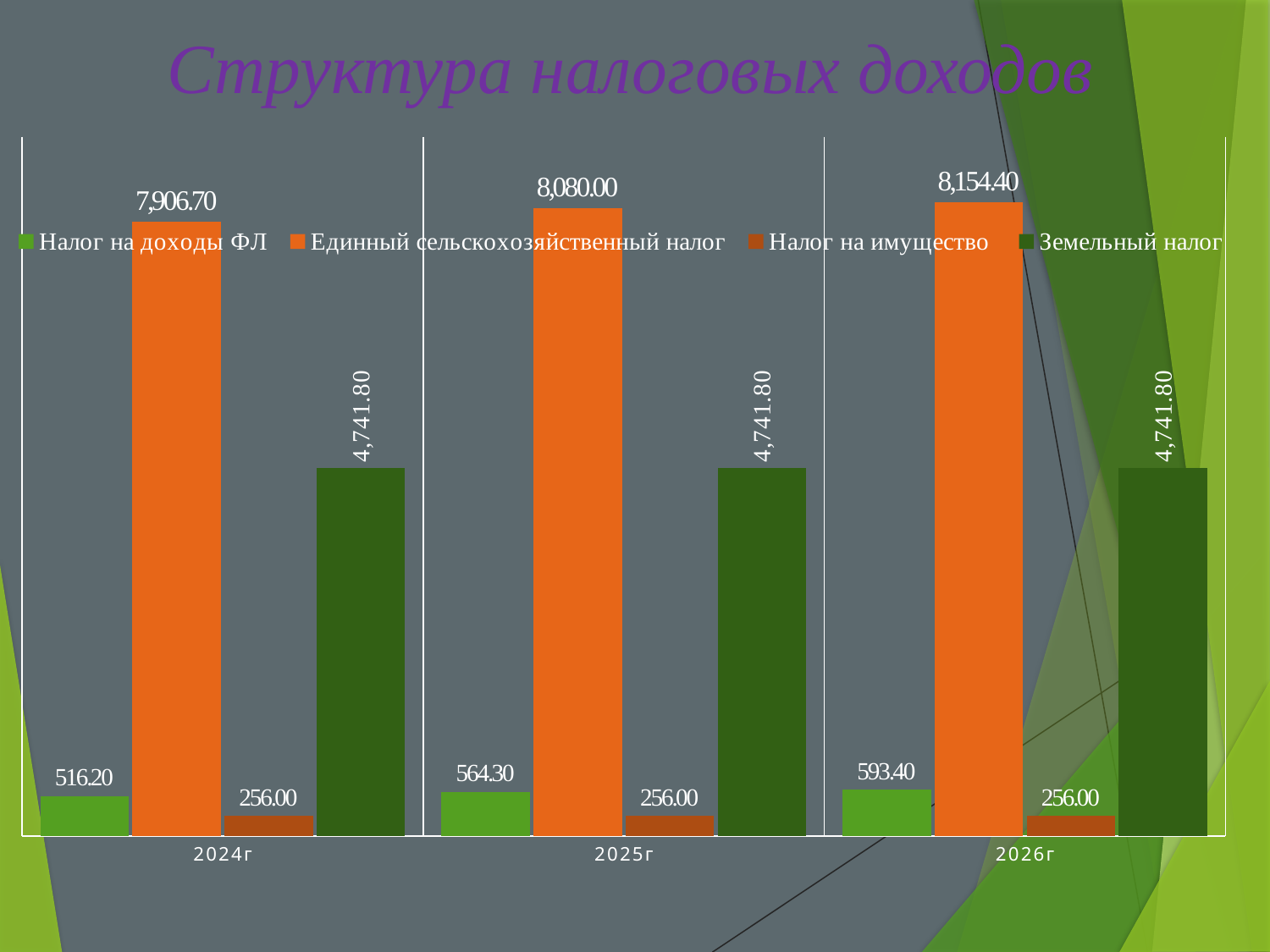
In which year is Единный сельскохозяйственный налог highest? 2026г What is the value of Налог на имущество for 2024г? 256.00 What is the difference between Единный сельскохозяйственный налог in 2026г and in 2024г? 247.70 What kind of chart is shown on the slide? Bar chart What is the value of Единный сельскохозяйственный налог for 2024г? 7,906.70 What is the value of Налог на доходы ФЛ for 2026г? 593.40 Which is larger: Налог на доходы ФЛ in 2025г or Налог на имущество in 2025г? Налог на доходы ФЛ in 2025г What is the value of Земельный налог for 2025г? 4,741.80 How many years are shown on the x axis? 3 Which series has the lowest value in 2025г? Налог на имущество How many series does the legend list? 4 Does Налог на доходы ФЛ rise or fall from 2024г to 2026г? Rise